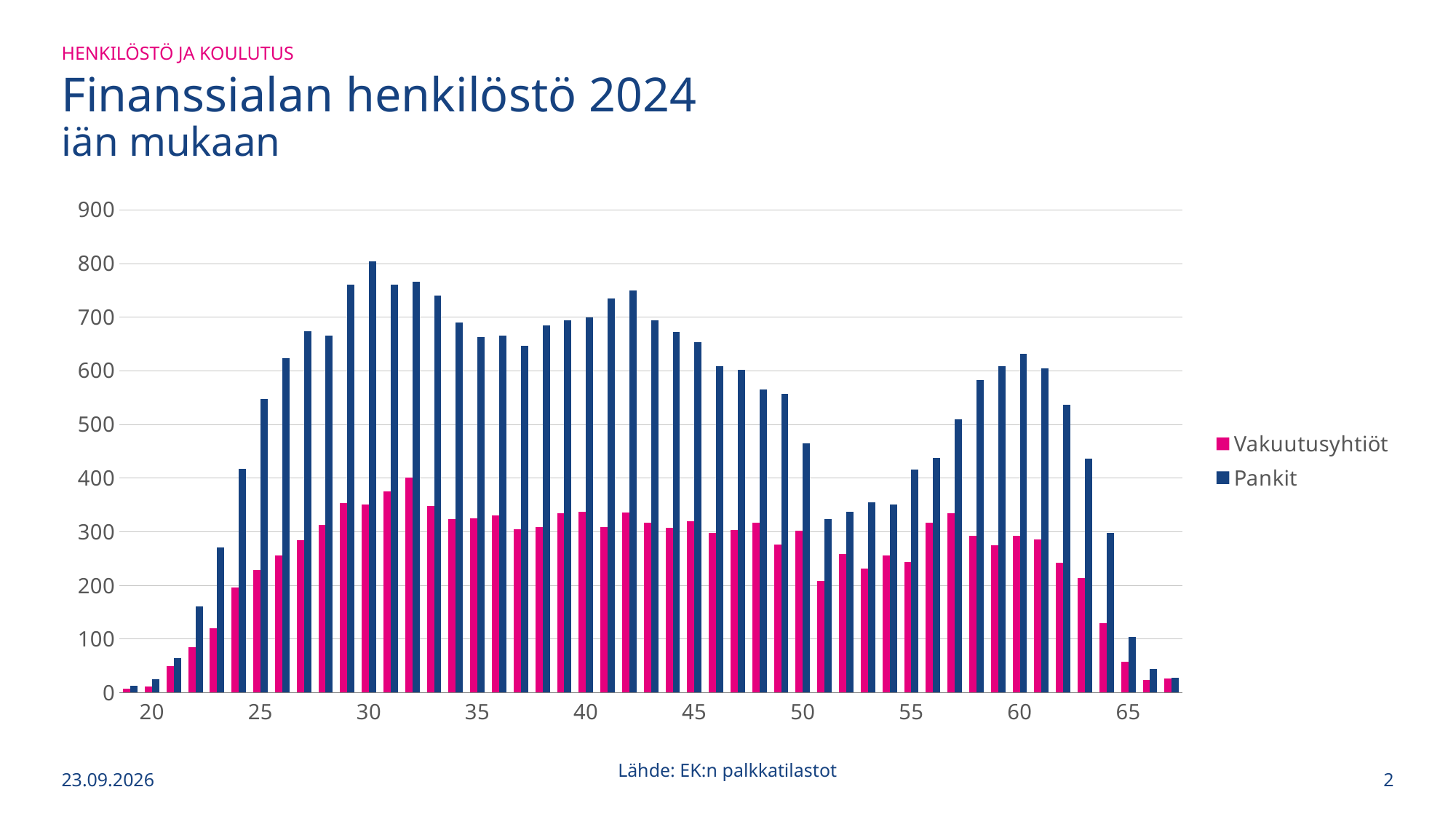
Do the Pankit values generally rise or fall from age 30 to age 50? fall What kind of chart is shown on the slide? bar chart At age 45, which series has the larger value, Pankit or Vakuutusyhtiöt? Pankit What are the two series named in the legend? Vakuutusyhtiöt and Pankit At which age is the Vakuutusyhtiöt value highest? 32 Is the Pankit value at age 50 greater or less than 500? less Is the Vakuutusyhtiöt value at age 40 greater or less than 300? greater Is the Vakuutusyhtiöt value at age 65 greater or less than 100? less How many series does the legend list? 2 At which age is the Pankit value highest? 30 Which series is drawn in dark blue? Pankit